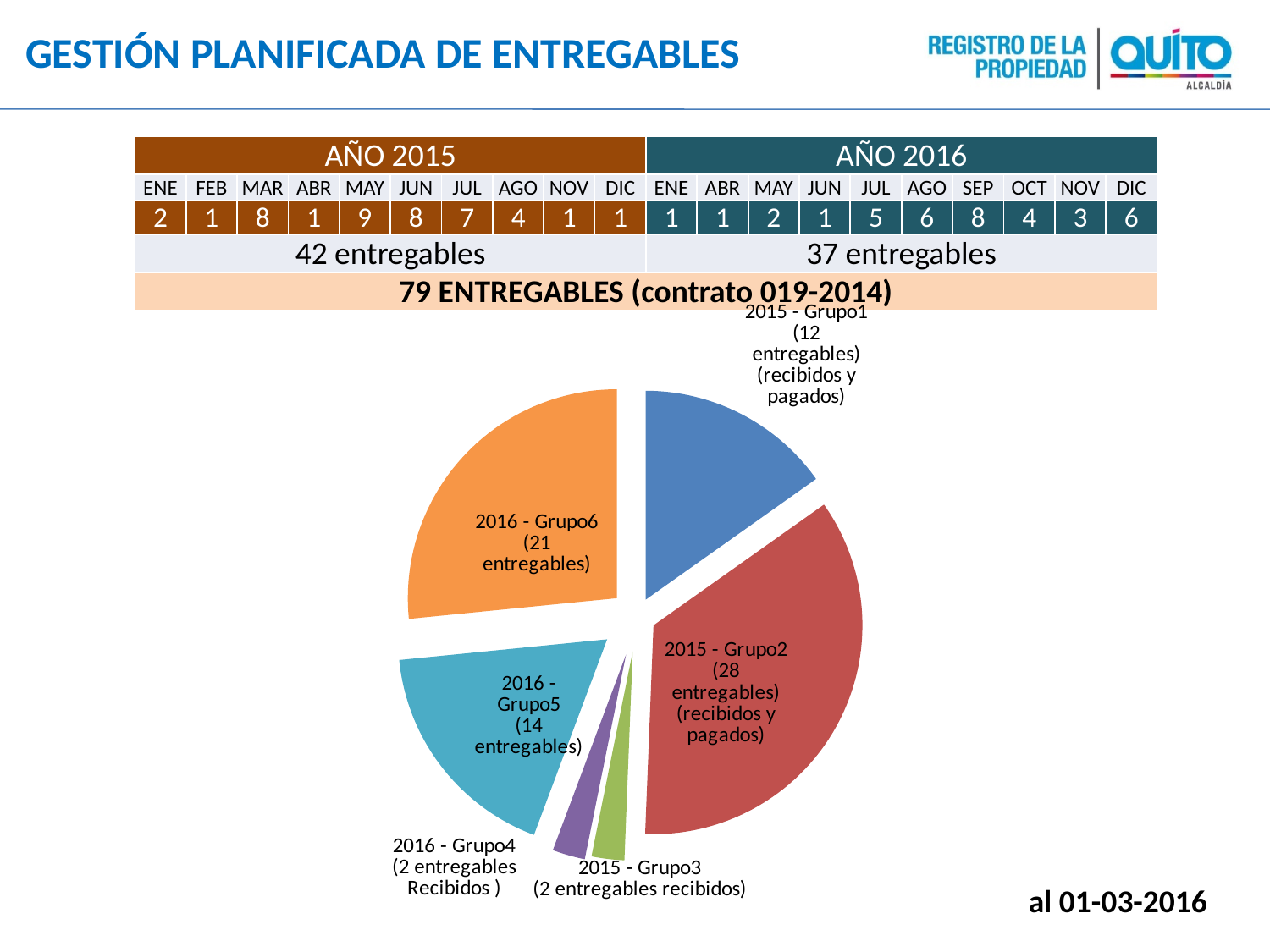
How many entregables does the 2015 - Grupo1 slice represent? 12 entregables How many entregables does the 2016 - Grupo6 slice represent? 21 entregables What colour is the 2015 - Grupo2 slice? red What is the difference in entregables between 2015 - Grupo2 and 2016 - Grupo6? 7 Which slice is larger, 2016 - Grupo5 or 2015 - Grupo1? 2016 - Grupo5 What is the total number of entregables across all slices of the pie chart? 79 What kind of chart is shown on the slide? pie chart How many entregables does the 2015 - Grupo3 slice represent? 2 entregables How many slices does the pie chart have? 6 How many entregables does the 2015 - Grupo2 slice represent? 28 entregables How many entregables does the 2016 - Grupo5 slice represent? 14 entregables Which group has the largest slice of the pie chart? 2015 - Grupo2